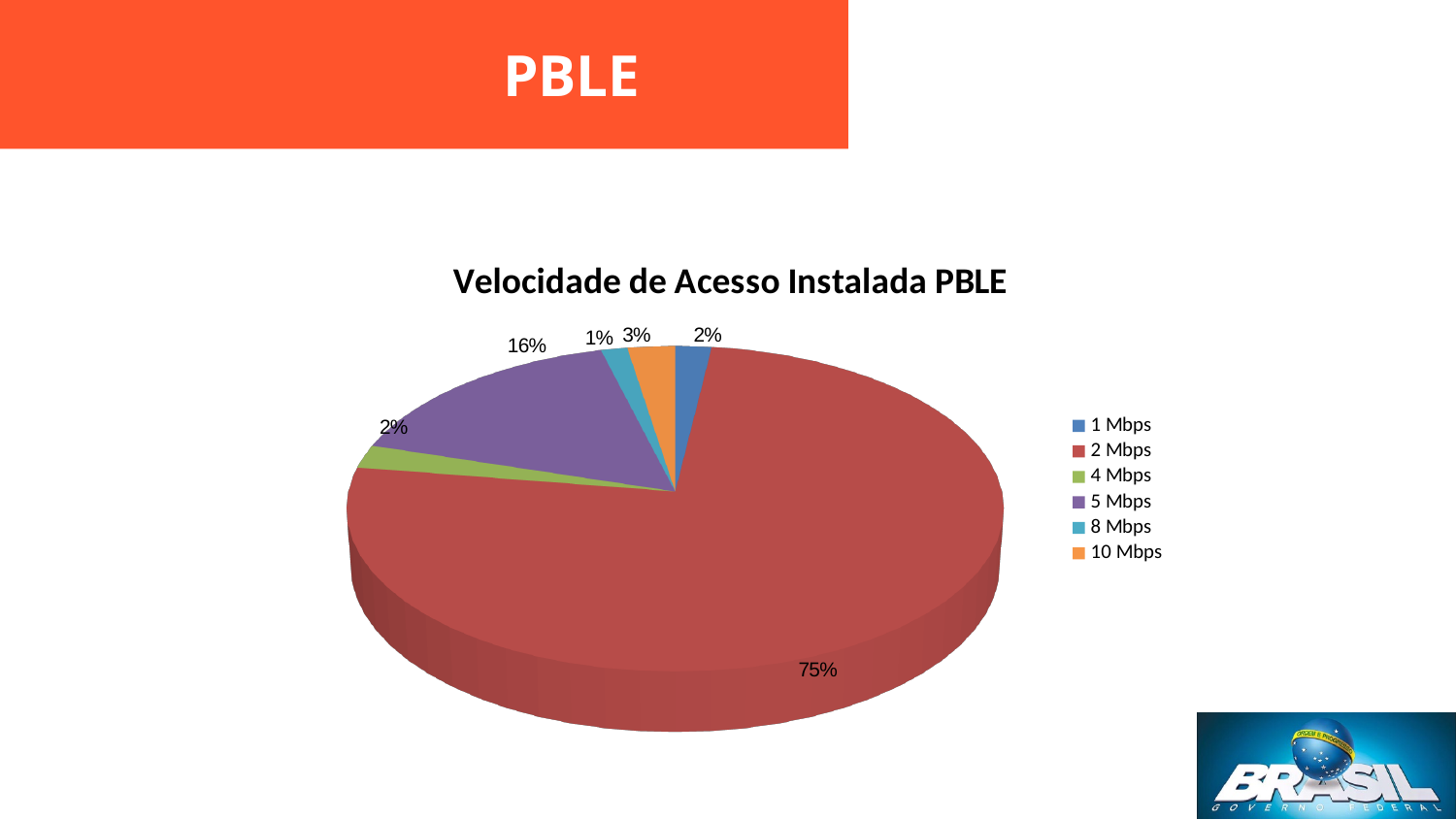
Which category has the largest slice of the pie? 2 Mbps What share of the pie does 2 Mbps represent? 75% What is the difference between the shares of 2 Mbps and 5 Mbps? 59% What is the value shown for 10 Mbps? 3% Which category has the smallest slice of the pie? 8 Mbps What kind of chart is shown on the slide? pie chart How many categories does the legend list? 6 What is the value shown for 1 Mbps? 2% Which is larger, the share for 5 Mbps or the share for 10 Mbps? 5 Mbps What is the value shown for 8 Mbps? 1% What share of the pie does 5 Mbps represent? 16% What is the title of the chart? Velocidade de Acesso Instalada PBLE